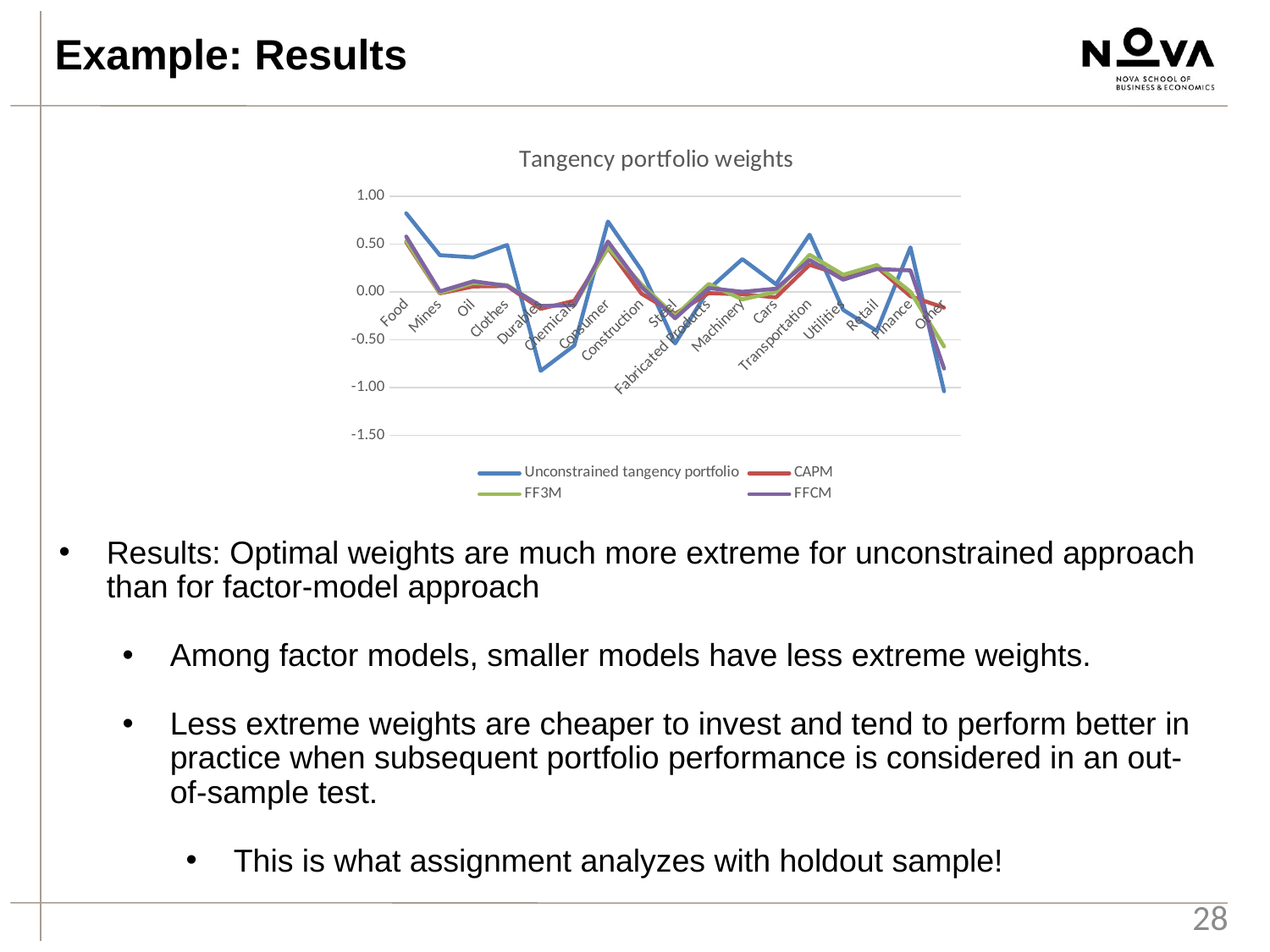
Is the value of the Unconstrained tangency portfolio for Other greater or less than -0.50? less Is the value of the Unconstrained tangency portfolio for Durables greater or less than -0.50? less For which category does the Unconstrained tangency portfolio series reach its lowest value? Other Which series are listed in the chart's legend? Unconstrained tangency portfolio, CAPM, FF3M, FFCM What kind of chart is shown on the slide? line chart For which category does the Unconstrained tangency portfolio series reach its highest value? Food How many industry categories are plotted along the x axis? 17 For Food, which series has the larger value: Unconstrained tangency portfolio or CAPM? Unconstrained tangency portfolio Is the value of the Unconstrained tangency portfolio for Food greater or less than 0.50? greater What is the title of the chart? Tangency portfolio weights How many series does the chart's legend list? 4